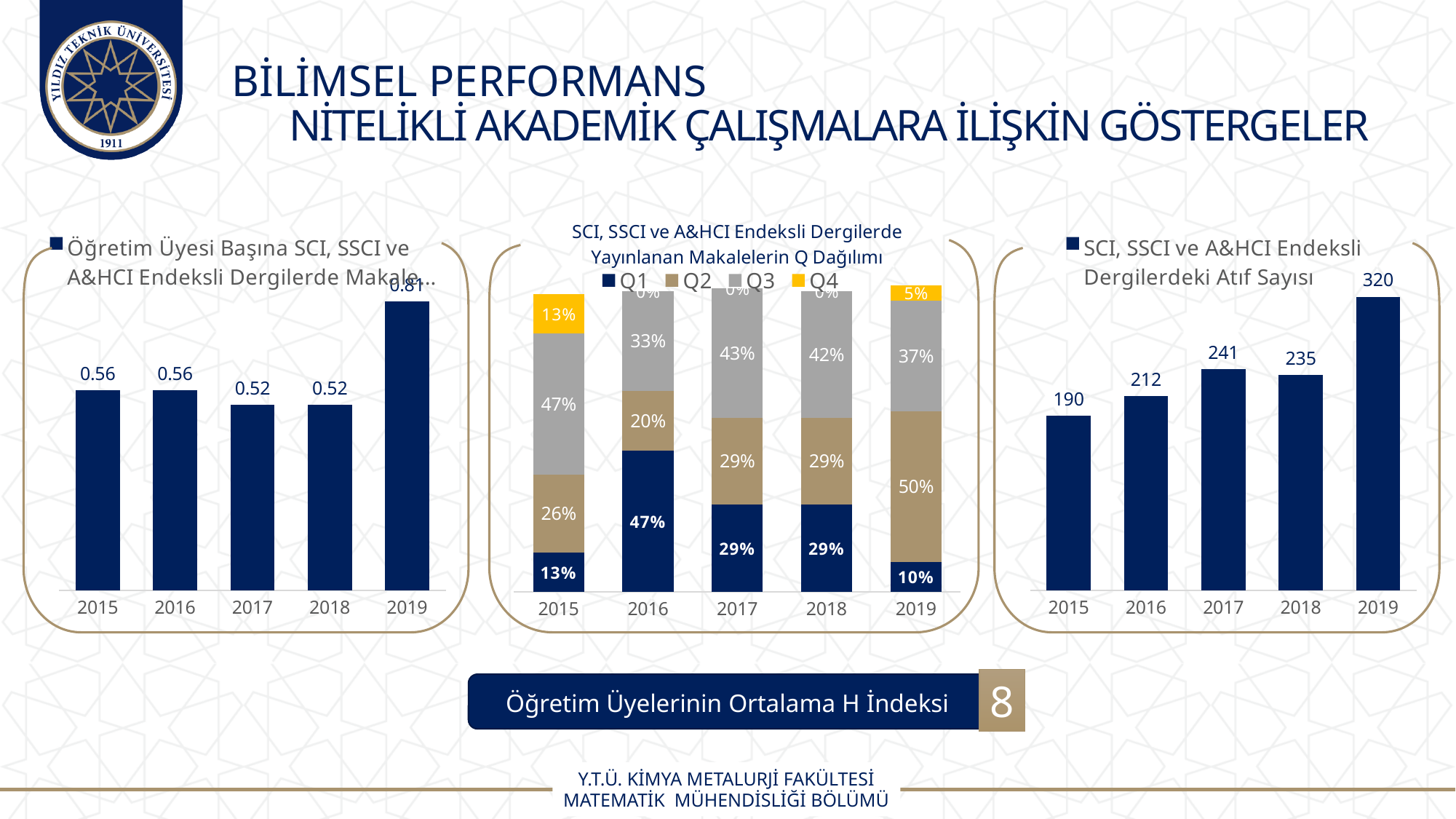
In the left-hand chart (Öğretim Üyesi Başına ... Makale), which year has the highest value? 2019 In the left-hand chart (Öğretim Üyesi Başına ... Makale), what is the value for 2017? 0.52 In the right-hand chart (SCI, SSCI ve A&HCI Endeksli Dergilerdeki Atıf Sayısı), what is the value for 2019? 320 In the middle chart (Q Dağılımı), what is the Q1 share for 2016? 47% In the middle chart (Q Dağılımı), what is the Q2 share for 2019? 50% In the right-hand chart (SCI, SSCI ve A&HCI Endeksli Dergilerdeki Atıf Sayısı), what is the difference between the 2019 and 2015 values? 130 In the middle chart (Q Dağılımı), how many series does the legend list? 4 In the right-hand chart (SCI, SSCI ve A&HCI Endeksli Dergilerdeki Atıf Sayısı), which year has the lowest value? 2015 In the left-hand chart (Öğretim Üyesi Başına ... Makale), how many years are shown on the x axis? 5 What kind of chart is the middle chart (Q Dağılımı)? Stacked bar chart In the right-hand chart (SCI, SSCI ve A&HCI Endeksli Dergilerdeki Atıf Sayısı), which is larger, the value for 2017 or the value for 2018? 2017 In the left-hand chart (Öğretim Üyesi Başına ... Makale), what is the value for 2019? 0.81